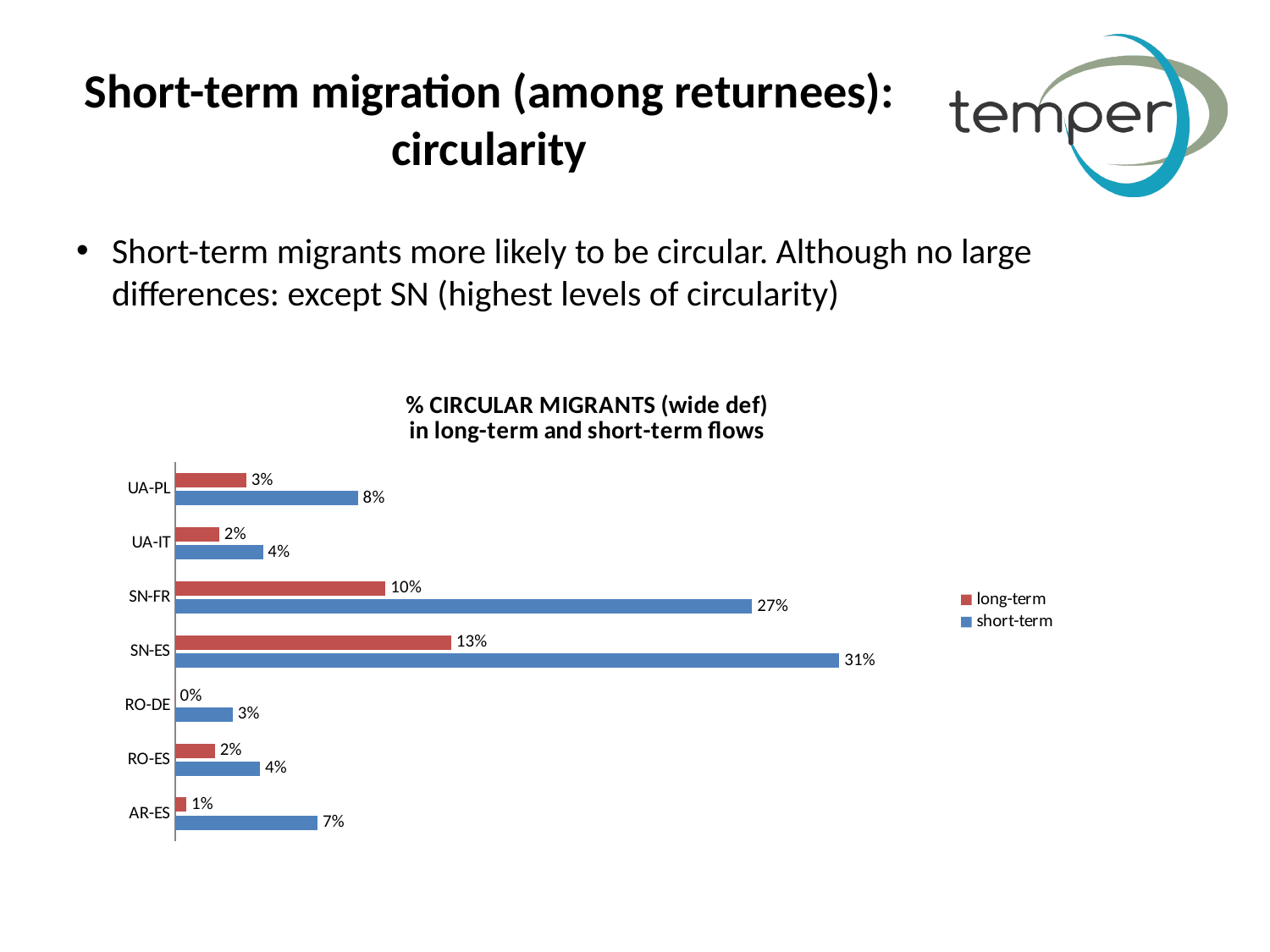
What is the difference between the short-term and long-term values for SN-FR? 17% Which is larger, the short-term value for AR-ES or the short-term value for RO-ES? AR-ES How many categories are shown on the chart? 7 How many series does the legend list? 2 Which colour represents the short-term series in the legend? Blue What is the long-term value for RO-DE? 0% Which category has the highest short-term value? SN-ES Which category has the lowest long-term value? RO-DE What is the short-term value for UA-PL? 8% What kind of chart is shown on the slide? Bar chart What is the short-term value for SN-ES? 31% What is the long-term value for SN-FR? 10%